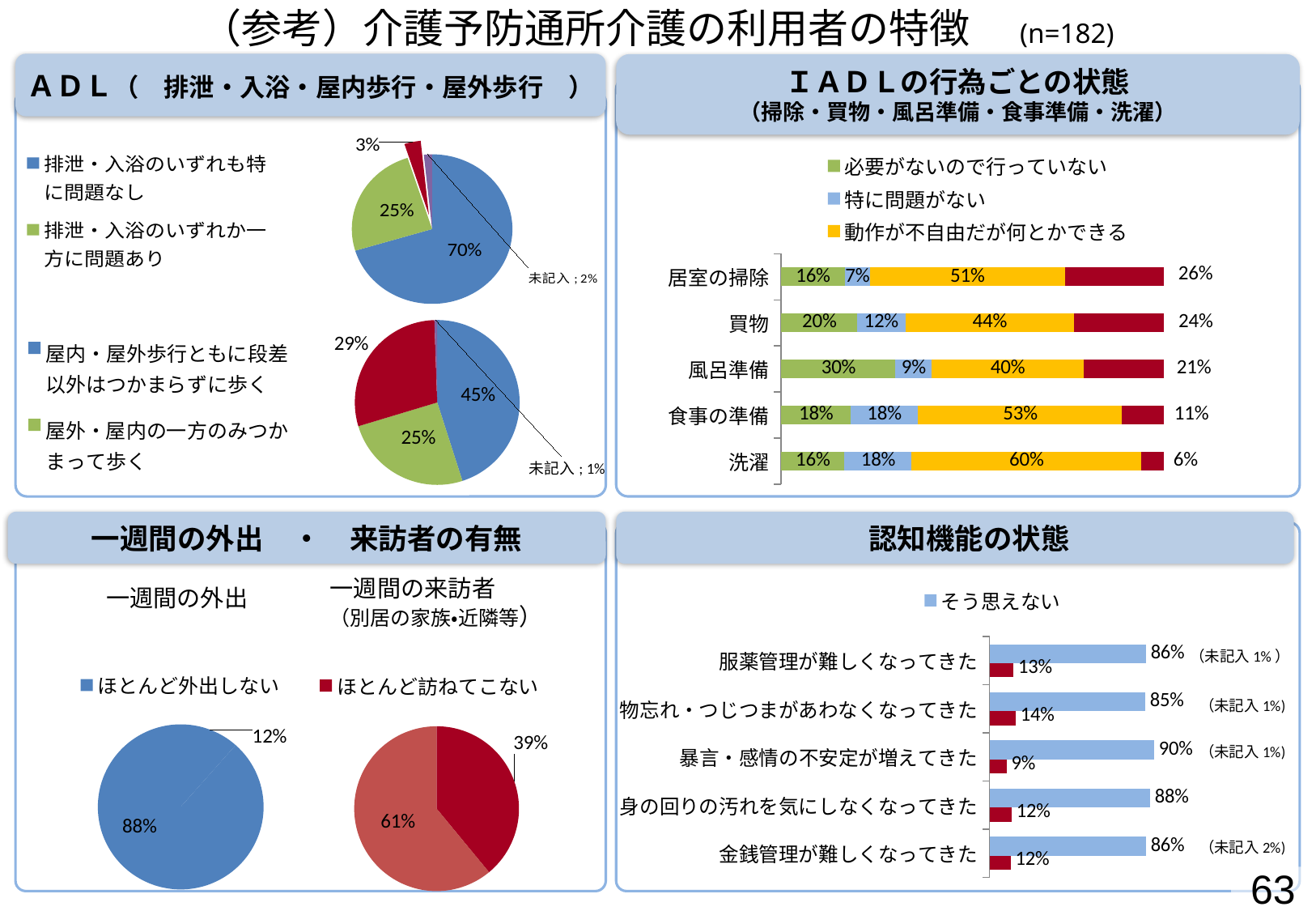
In the IADL chart (ＩＡＤＬの行為ごとの状態), how many series does the legend list? 3 In the IADL chart (ＩＡＤＬの行為ごとの状態), what is the value of the yellow segment (動作が不自由だが何とかできる) for 洗濯? 60% In the IADL chart (ＩＡＤＬの行為ごとの状態), what is the difference between the yellow segment values for 洗濯 and 風呂準備? 20% In the 一週間の来訪者 pie chart, what share does ほとんど訪ねてこない (dark red) have? 39% In the IADL chart (ＩＡＤＬの行為ごとの状態), which category has the highest value for 必要がないので行っていない (green)? 風呂準備 In the upper ADL pie chart (排泄・入浴), what share does 排泄・入浴のいずれも特に問題なし have? 70% In the 認知機能の状態 chart, which is larger: the red bar for 物忘れ・つじつまがあわなくなってきた or the red bar for 暴言・感情の不安定が増えてきた? 物忘れ・つじつまがあわなくなってきた In the 認知機能の状態 chart, what is the value of the blue bar (そう思えない) for 暴言・感情の不安定が増えてきた? 90% In the 一週間の外出 pie chart, what share does ほとんど外出しない (blue) have? 12% In the IADL chart (ＩＡＤＬの行為ごとの状態), how many categories are plotted? 5 In the 認知機能の状態 chart, which category has the highest value for そう思えない? 暴言・感情の不安定が増えてきた In the IADL chart (ＩＡＤＬの行為ごとの状態), which category has the lowest value for the red segment shown at the right end of the bars? 洗濯